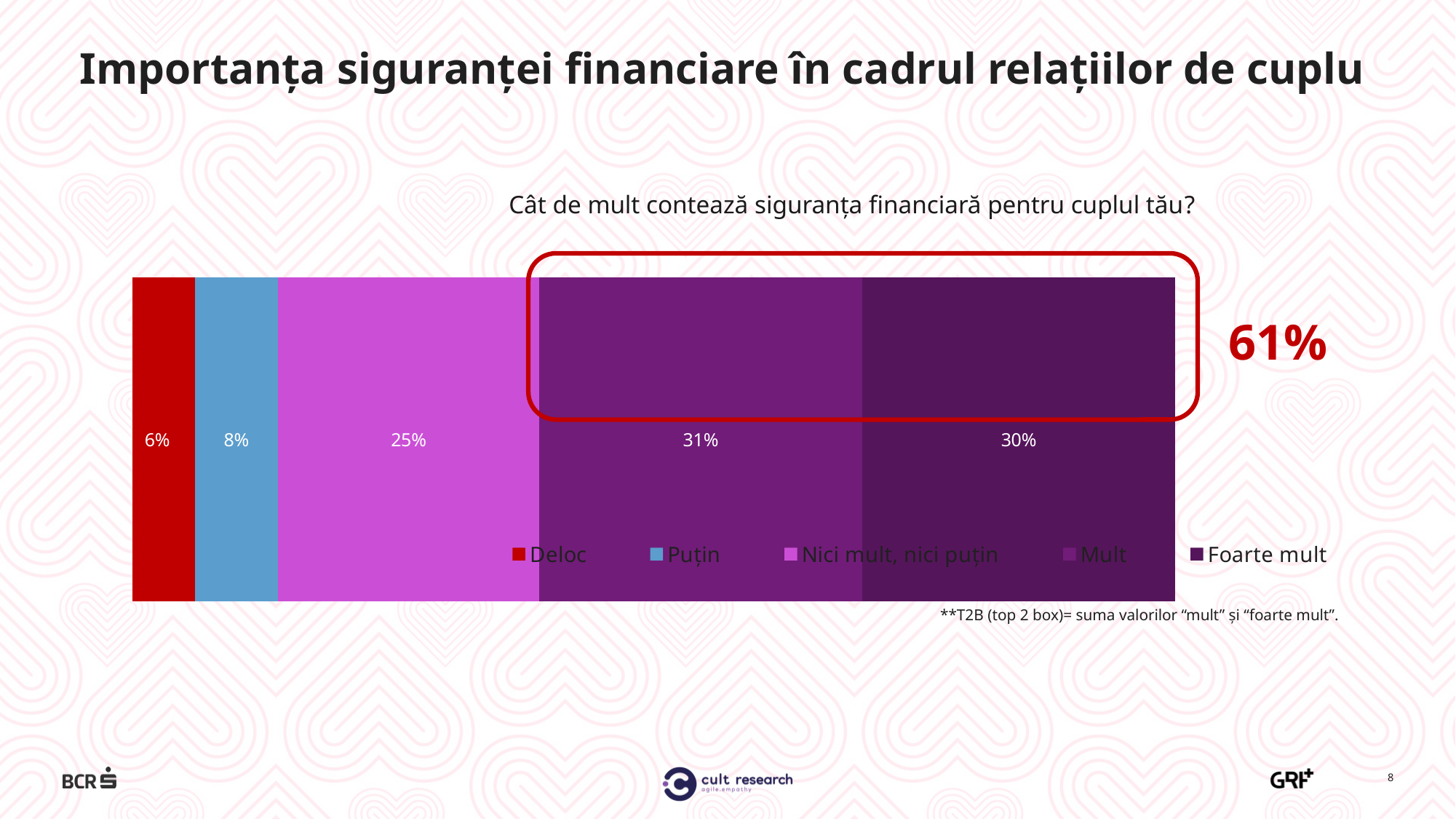
How many response categories does the legend list? 5 What is the difference between the "Nici mult, nici puțin" share and the "Puțin" share? 17% What percentage of respondents answered "Foarte mult"? 30% What percentage of respondents answered "Mult"? 31% Which is larger, the share for "Puțin" or the share for "Deloc"? Puțin What question is shown as the chart's title? Cât de mult contează siguranța financiară pentru cuplul tău? What percentage of respondents answered "Deloc"? 6% What percentage of respondents answered "Nici mult, nici puțin"? 25% What is the combined share of "Mult" and "Foarte mult" (the T2B value highlighted on the slide)? 61% Which response category has the smallest share? Deloc Which response category has the largest share? Mult What kind of chart is shown on the slide? Stacked bar chart